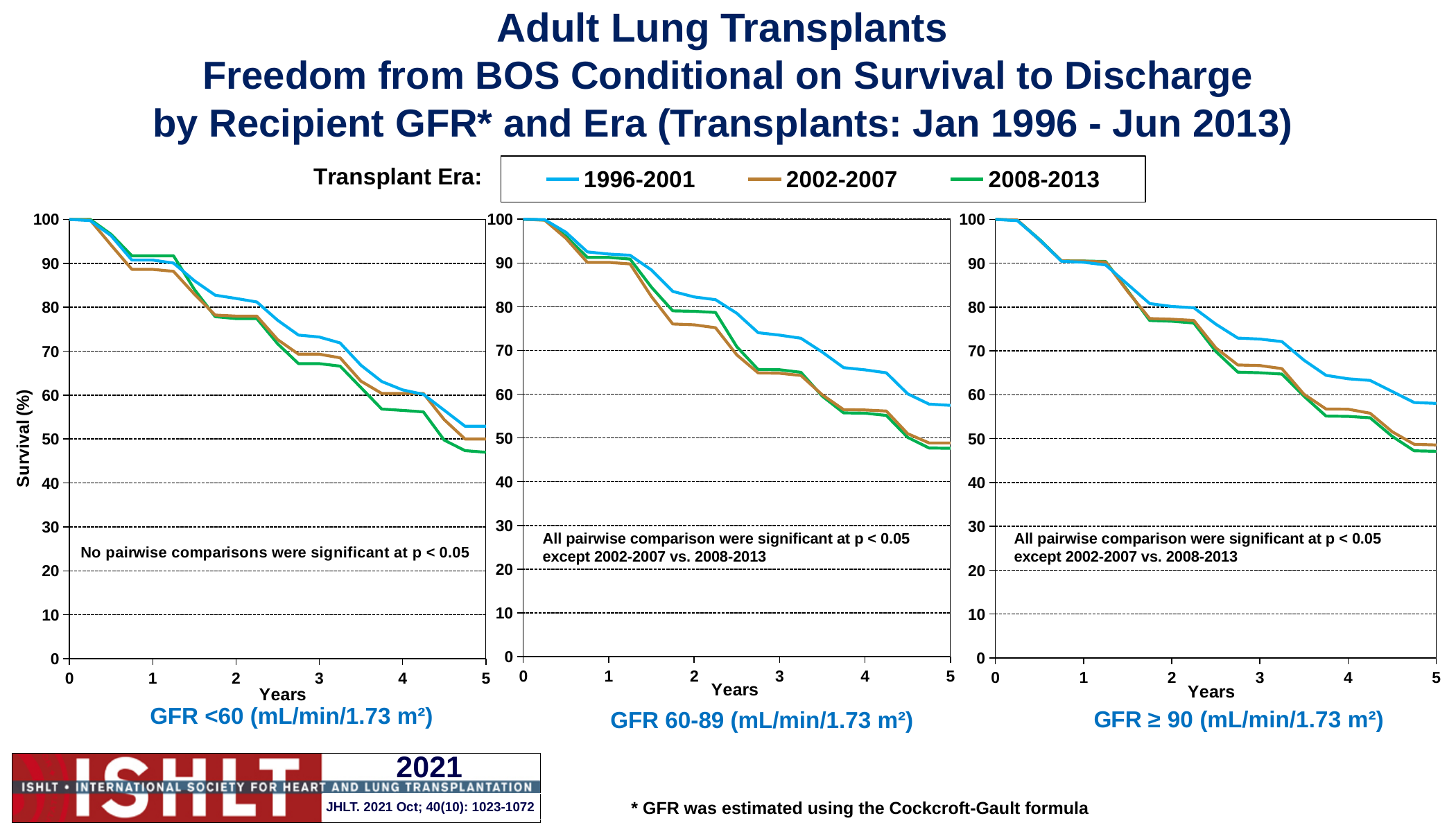
How many transplant eras does the legend list? 3 In the GFR 60-89 (mL/min/1.73 m²) chart, is the value for 2008-2013 at year 5 greater or less than 50? less What kind of chart is the GFR <60 (mL/min/1.73 m²) chart? line chart In the GFR ≥ 90 (mL/min/1.73 m²) chart, what is the survival value for all eras at year 0? 100 In the GFR ≥ 90 (mL/min/1.73 m²) chart, is the value for 1996-2001 at year 5 greater or less than 50? greater In the GFR <60 (mL/min/1.73 m²) chart, is the value for 2008-2013 at year 5 greater or less than 50? less In the GFR 60-89 (mL/min/1.73 m²) chart, which era has the higher value at year 5: 1996-2001 or 2008-2013? 1996-2001 In the GFR 60-89 (mL/min/1.73 m²) chart, does the 1996-2001 line rise or fall as years increase? fall In the GFR ≥ 90 (mL/min/1.73 m²) chart, which era has the higher value at year 3: 1996-2001 or 2008-2013? 1996-2001 What is the label of the y axis on the GFR <60 (mL/min/1.73 m²) chart? Survival (%) Which transplant era is shown in green in the legend? 2008-2013